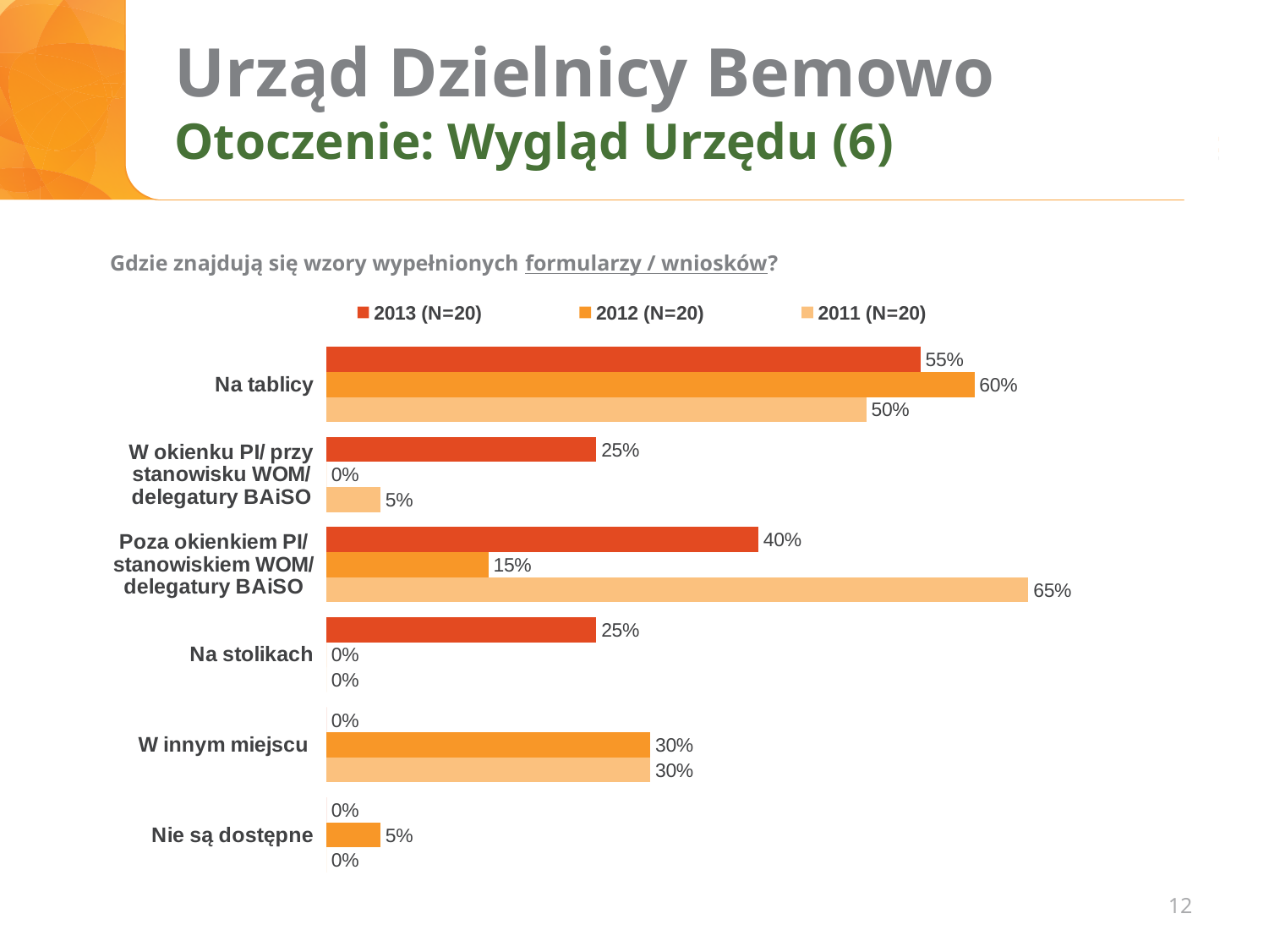
Which category has the highest value in the 2011 (N=20) series? Poza okienkiem PI/ stanowiskiem WOM/ delegatury BAiSO How many categories are shown on the chart? 6 What is the difference between the 2013 and 2012 values for 'Poza okienkiem PI/ stanowiskiem WOM/ delegatury BAiSO'? 25% Which is larger for 'Na tablicy': the 2012 (N=20) value or the 2011 (N=20) value? 2012 (N=20) What question does the chart answer, as stated above it? Gdzie znajdują się wzory wypełnionych formularzy / wniosków? How many series does the legend list? 3 What is the value for 'W innym miejscu' in the 2012 (N=20) series? 30% What kind of chart is shown on the slide? Bar chart What is the value for 'Poza okienkiem PI/ stanowiskiem WOM/ delegatury BAiSO' in the 2011 (N=20) series? 65% What is the value for 'Nie są dostępne' in the 2012 (N=20) series? 5% What is the value for 'Na tablicy' in the 2013 (N=20) series? 55% Which category has the highest value in the 2012 (N=20) series? Na tablicy